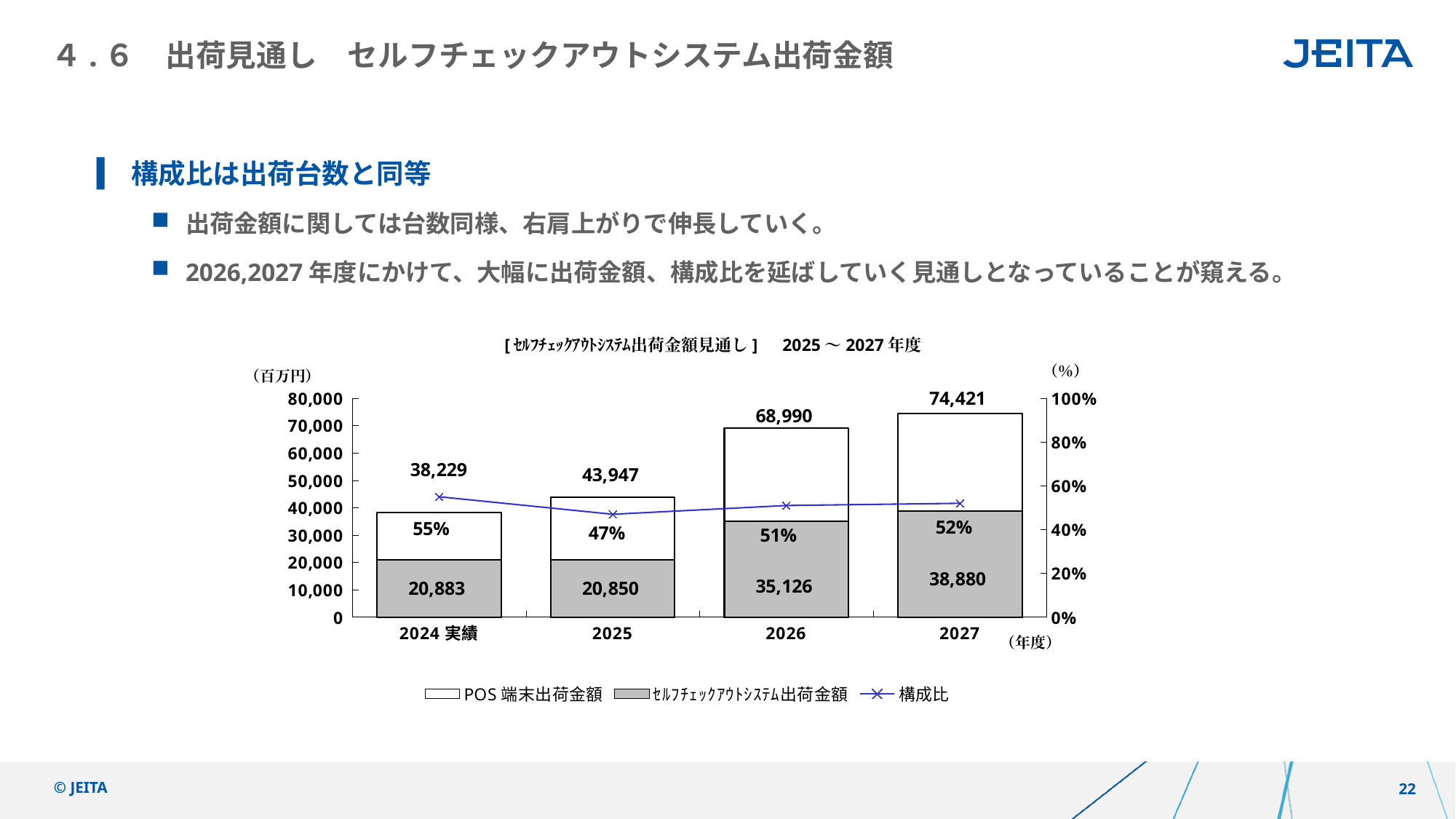
Which year has the lowest 構成比? 2025 What is the total shipment value (top label) for 2027? 74,421 What is the difference between the total shipment values for 2026 and 2025? 25,043 What is the 構成比 value shown for 2025? 47% What is the セルフチェックアウトシステム出荷金額 value for 2026? 35,126 Which is larger, the セルフチェックアウトシステム出荷金額 for 2024 実績 or for 2025? 2024 実績 How many years are shown on the x axis? 4 Do the total shipment values rise or fall from 2024 実績 to 2027? rise Which year has the highest total shipment value? 2027 What kind of chart is this? Stacked bar chart with a line How many series does the legend list? 3 Is the total bar for 2026 greater or less than 60,000? greater